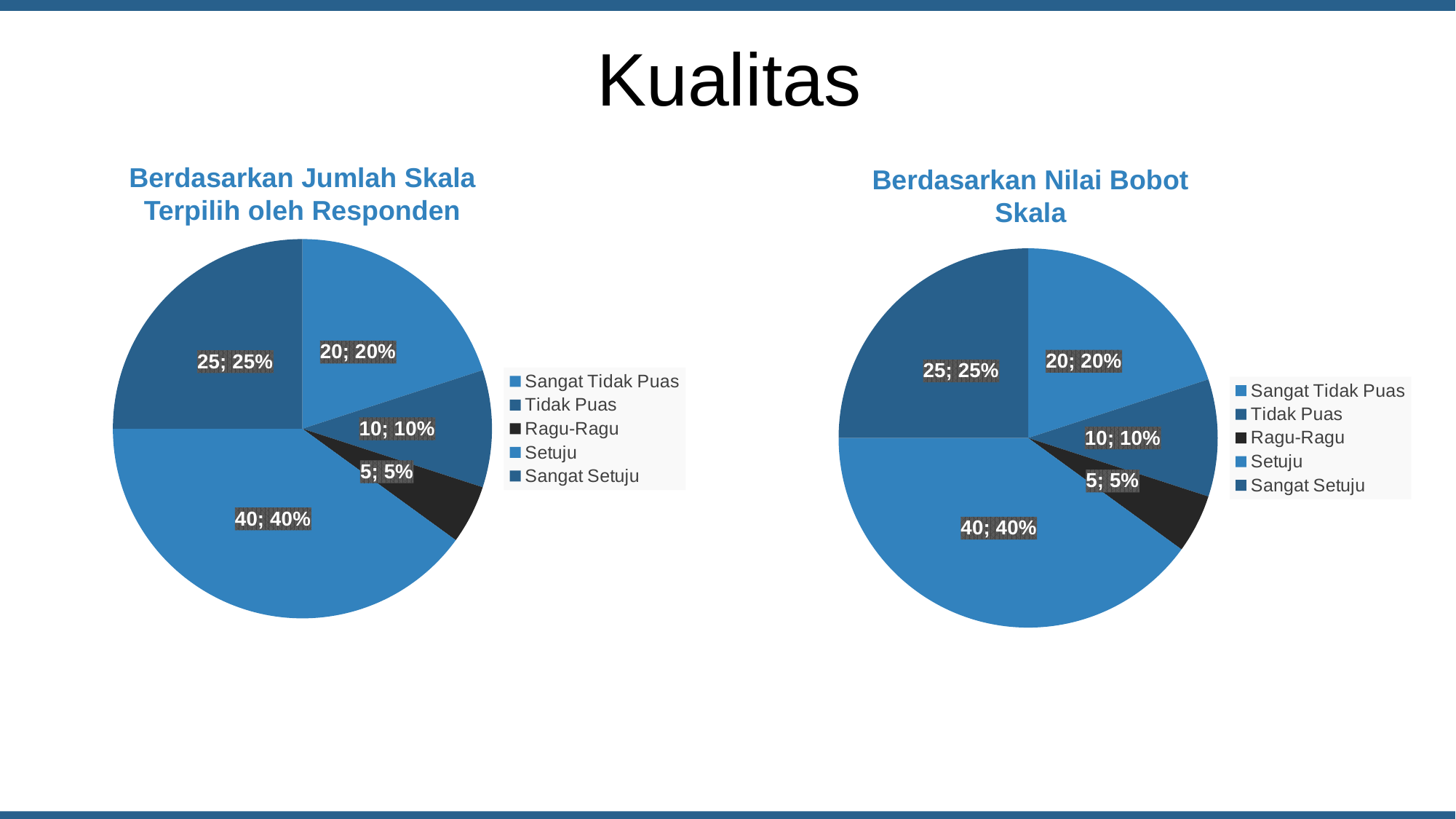
In the left chart, what is the difference between the values for Setuju and Sangat Tidak Puas? 20 What type of chart is "Berdasarkan Nilai Bobot Skala"? Pie chart How many categories does the legend of the left chart list? 5 In the left chart, what is the value shown for Sangat Setuju? 25; 25% In the chart titled "Berdasarkan Nilai Bobot Skala", what is the value shown for Ragu-Ragu? 5; 5% In the chart titled "Berdasarkan Jumlah Skala Terpilih oleh Responden", which category has the largest slice? Setuju In the right chart, which is larger, Sangat Setuju or Tidak Puas? Sangat Setuju In the chart titled "Berdasarkan Jumlah Skala Terpilih oleh Responden", what is the value shown for Setuju? 40; 40% In the chart titled "Berdasarkan Nilai Bobot Skala", which category has the smallest slice? Ragu-Ragu What share of the pie does Sangat Tidak Puas take in the chart titled "Berdasarkan Nilai Bobot Skala"? 20% In the right chart, what is the value shown for Tidak Puas? 10; 10% In the left chart, which category is shown in black? Ragu-Ragu